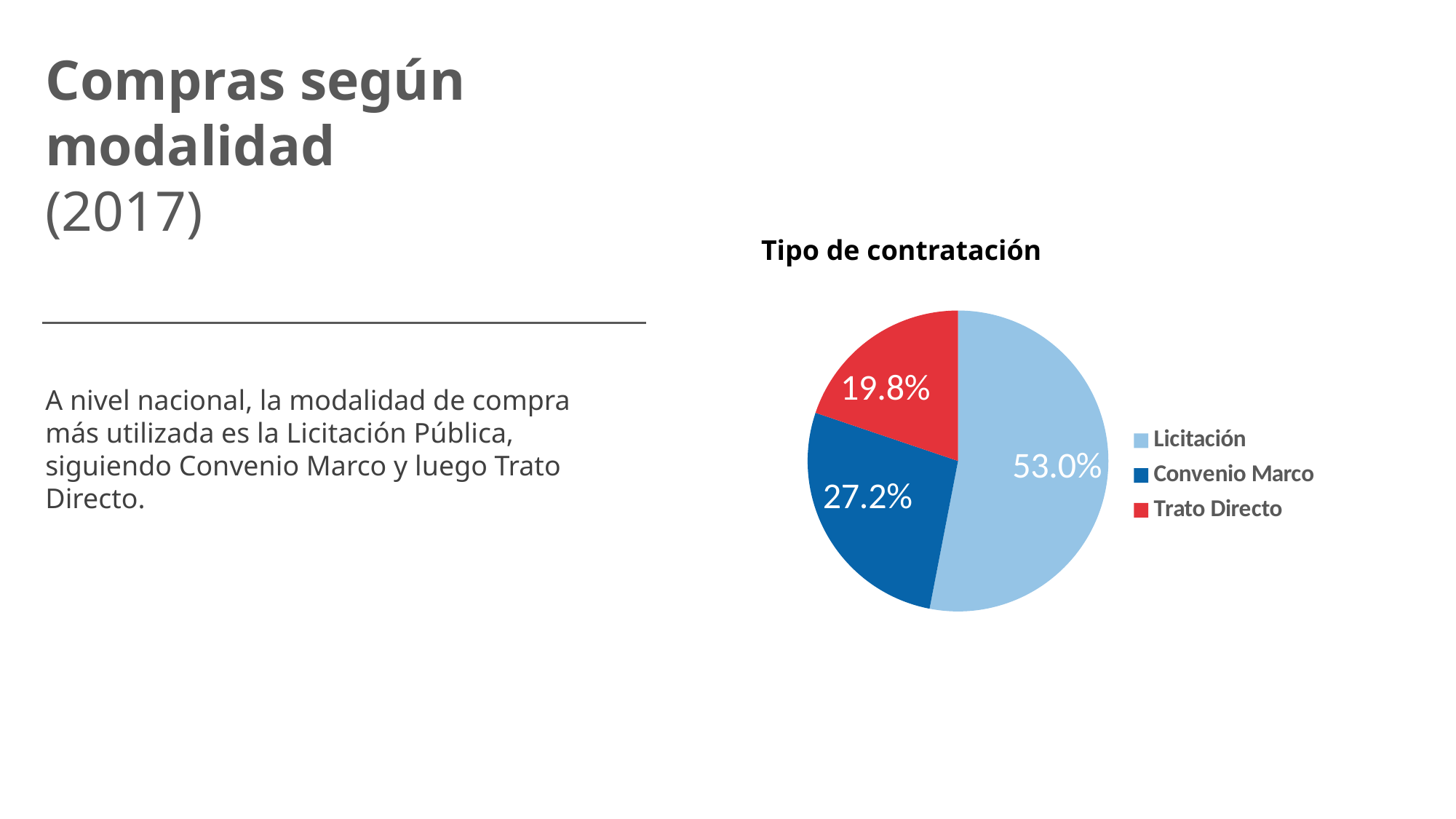
What colour is the Trato Directo slice? Red What is the value shown for Convenio Marco? 27.2% What is the difference between the Licitación and Convenio Marco shares? 25.8% Which category has the largest slice of the pie? Licitación What is the title of the chart? Tipo de contratación What is the difference between the Convenio Marco and Trato Directo shares? 7.4% Which is larger, the share for Convenio Marco or the share for Trato Directo? Convenio Marco What kind of chart is shown on the slide? Pie chart What share of the pie does Licitación represent? 53.0% Which category has the smallest slice of the pie? Trato Directo What is the value shown for Trato Directo? 19.8% How many categories does the pie chart show? 3